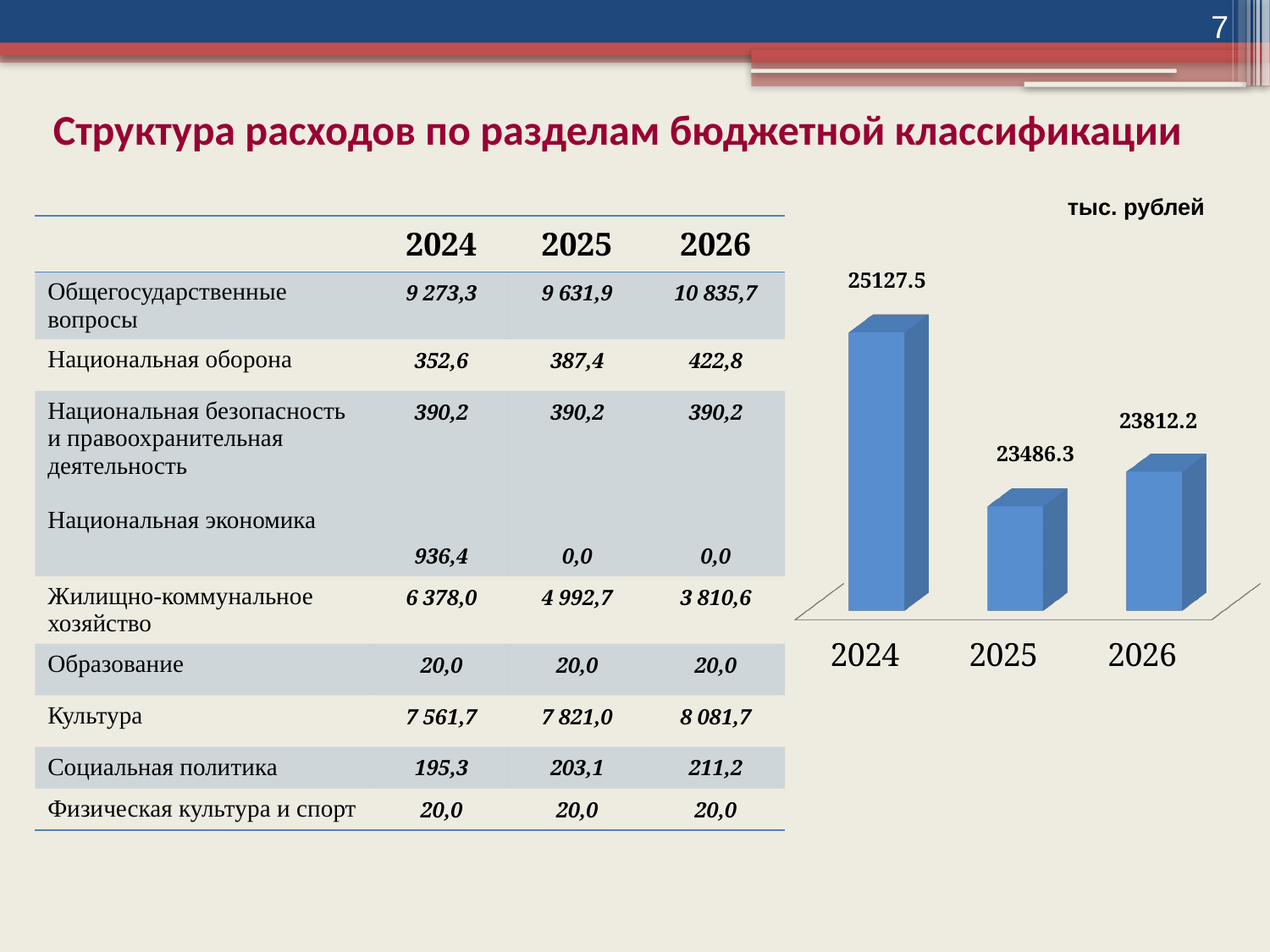
What value does the bar chart show for 2025? 23486.3 In the bar chart, which is larger: the value for 2025 or the value for 2026? 2026 Which year has the highest value in the bar chart? 2024 What value does the bar chart show for 2024? 25127.5 Which year has the lowest value in the bar chart? 2025 In the bar chart, what is the difference between the 2026 value and the 2025 value? 325.9 What kind of chart is shown on the right of the slide? Bar chart How many bars are shown in the bar chart? 3 In the bar chart, what is the difference between the 2024 value and the 2025 value? 1641.2 What unit is indicated above the bar chart? тыс. рублей In the bar chart, does the value rise or fall from 2024 to 2025? Fall What value does the bar chart show for 2026? 23812.2